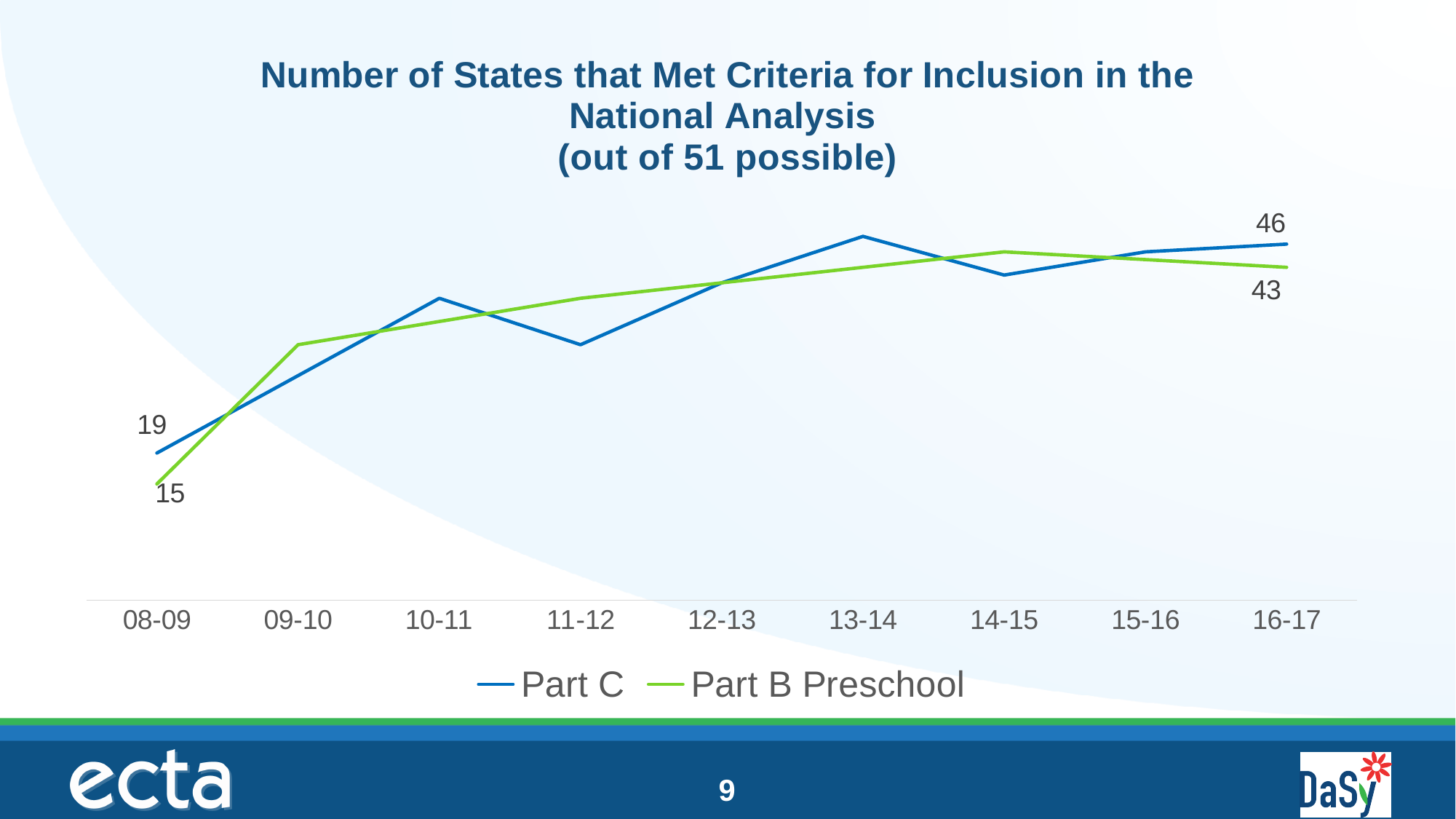
In which year is the Part C value lowest? 08-09 What is the difference between the Part C and Part B Preschool values in 16-17? 3 By how much did the Part C value increase from 08-09 to 16-17? 27 Does the Part B Preschool line rise or fall overall from 08-09 to 16-17? rise How many years are shown on the x axis? 9 How many series does the legend list? 2 What is the value for Part C in 16-17? 46 What kind of chart is shown on the slide? line chart In 08-09, which series has the higher value, Part C or Part B Preschool? Part C What is the value for Part C in 08-09? 19 What is the value for Part B Preschool in 08-09? 15 What is the value for Part B Preschool in 16-17? 43